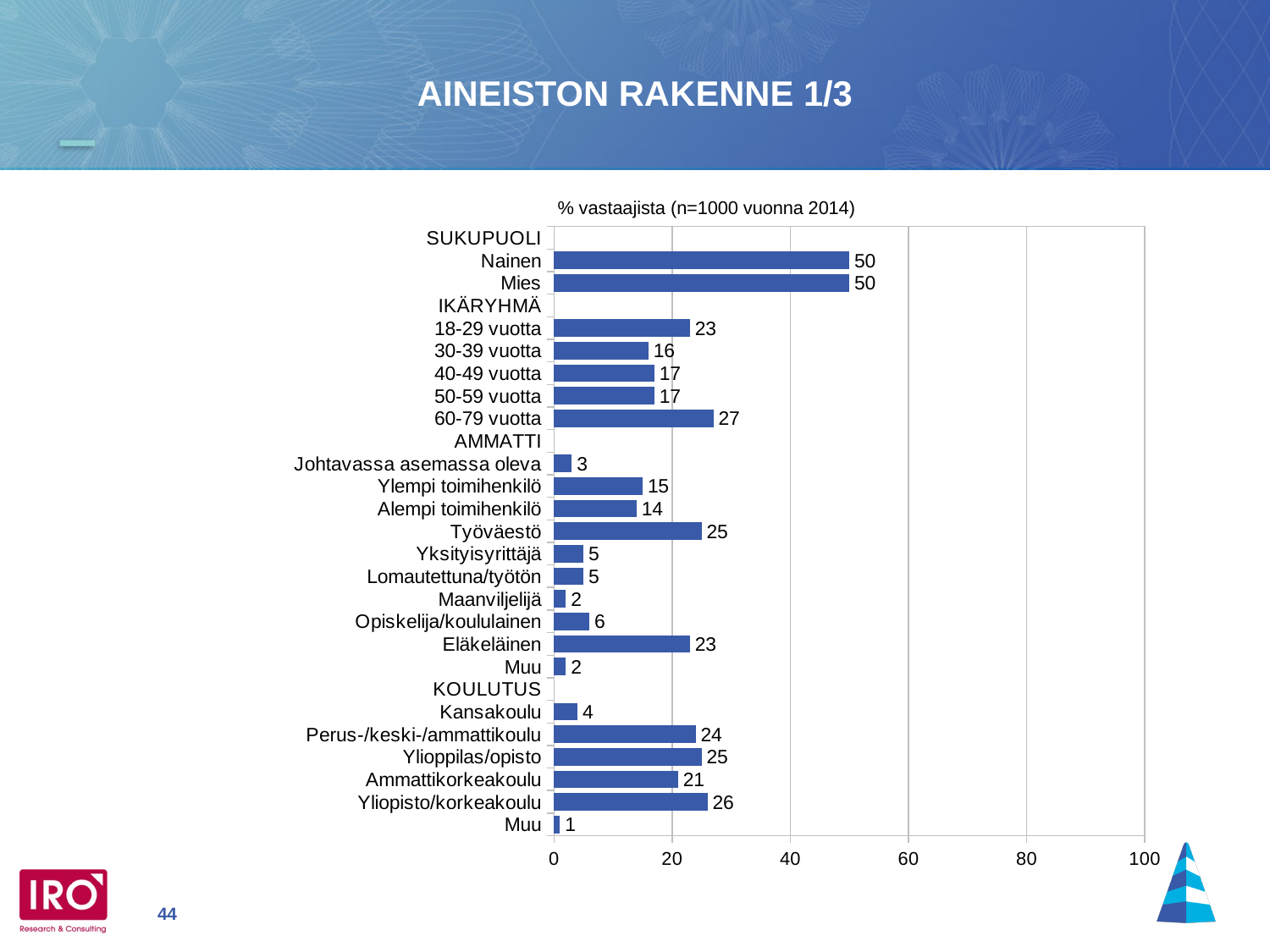
What is the value for Työväestö? 25 How many age groups are listed under IKÄRYHMÄ? 5 Which education category (KOULUTUS) has the lowest value? Muu Is the value for Nainen greater or less than 40? greater What is the difference between the values for Eläkeläinen and Opiskelija/koululainen? 17 What kind of chart is shown on the slide? bar chart What is the value for Yliopisto/korkeakoulu? 26 Which age group (IKÄRYHMÄ) has the highest value? 60-79 vuotta Which is larger, the value for Ylempi toimihenkilö or Alempi toimihenkilö? Ylempi toimihenkilö What is the value for Johtavassa asemassa oleva? 3 What is the value for 60-79 vuotta? 27 What is the title shown above the chart? % vastaajista (n=1000 vuonna 2014)